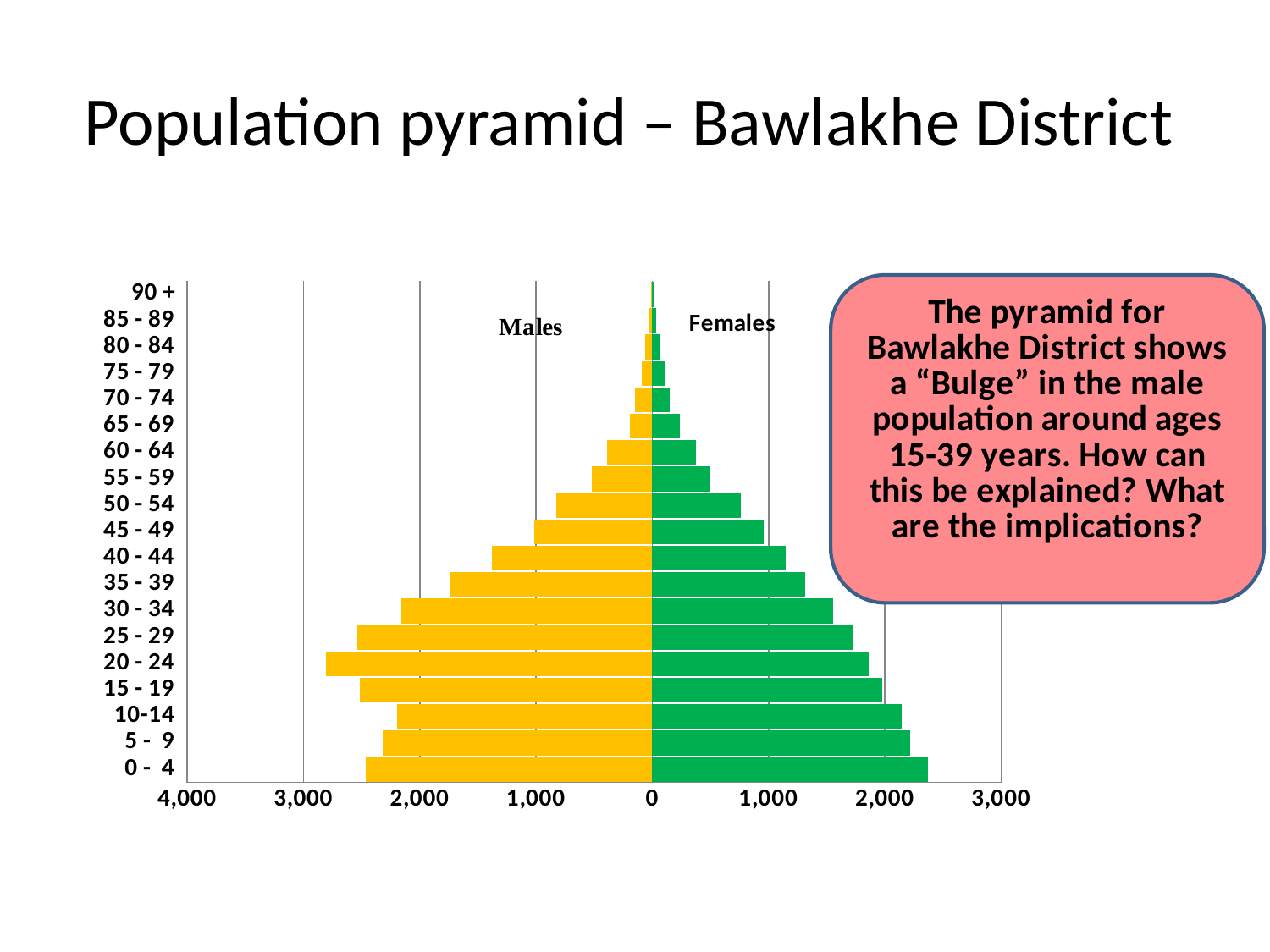
How many series does the population pyramid show? 2 What kind of chart is shown on the slide? Bar chart (population pyramid) Which age group has the smallest female population? 90 + Is the male population for the 20 - 24 age group greater or less than 2,000? greater Which colour represents females in the population pyramid? Green Which age group has the largest female population? 0 - 4 Is the male population for the 50 - 54 age group greater or less than 1,000? less Which age group has the largest male population? 20 - 24 In the 20 - 24 age group, is the male or the female population larger? Male How many age groups are shown on the vertical axis of the population pyramid? 19 Do the female bars rise or fall as the age groups go from 0 - 4 up to 90 +? fall Is the female population for the 0 - 4 age group greater or less than 2,000? greater